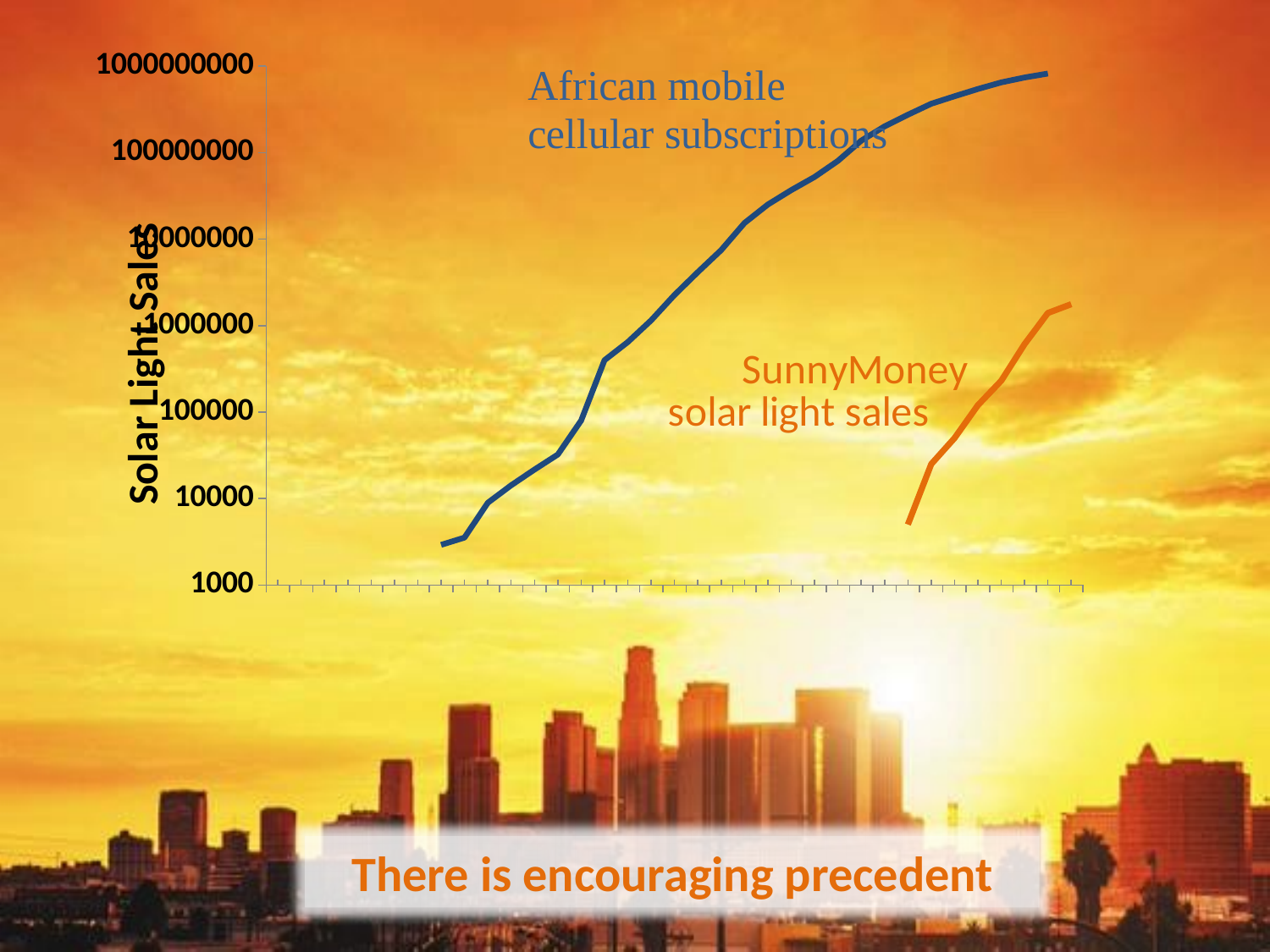
Is the lowest value of the African mobile cellular subscriptions line greater or less than 10000? less Which series is drawn in orange? SunnyMoney solar light sales Does the African mobile cellular subscriptions line rise or fall from left to right? rise Is the lowest value of the SunnyMoney solar light sales line greater or less than 10000? less Is the highest value of the African mobile cellular subscriptions line greater or less than 100000000? greater What is the lowest tick value shown on the vertical axis? 1000 Which series reaches the higher peak value, African mobile cellular subscriptions or SunnyMoney solar light sales? African mobile cellular subscriptions Does the SunnyMoney solar light sales line rise or fall from left to right? rise What kind of chart is shown on the slide? line chart What is the title of the vertical axis? Solar Light Sales How many data series are plotted on the chart? 2